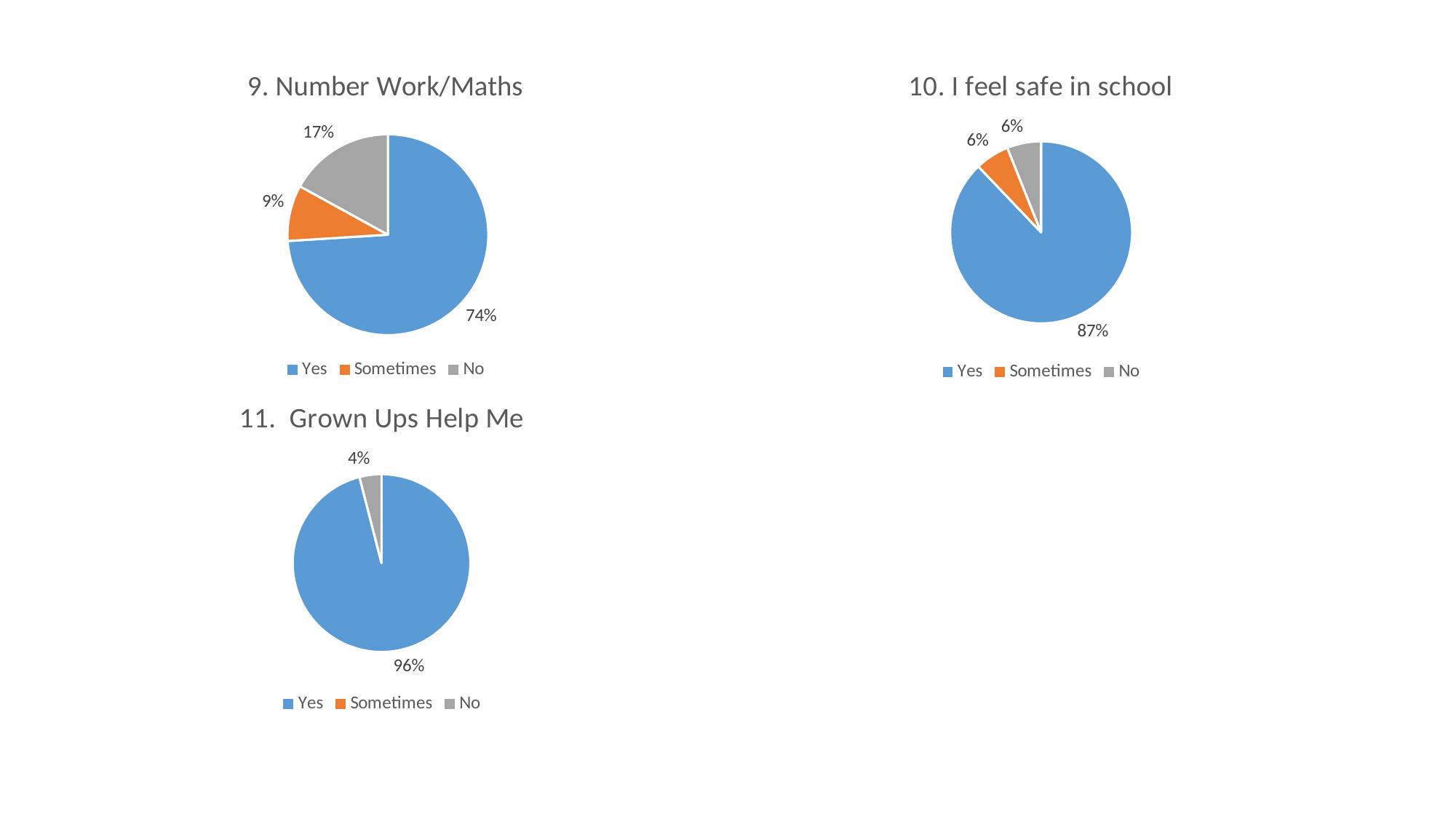
In the "10. I feel safe in school" chart, what percentage is shown for Sometimes? 6% Which chart has the larger Yes share, "9. Number Work/Maths" or "11. Grown Ups Help Me"? 11. Grown Ups Help Me In the "9. Number Work/Maths" chart, what percentage is shown for Sometimes? 9% In the "9. Number Work/Maths" chart, which category has the smallest slice? Sometimes In the "11. Grown Ups Help Me" chart, what percentage is shown for Yes? 96% In the "9. Number Work/Maths" chart, what percentage is shown for No? 17% In the "11. Grown Ups Help Me" chart, what percentage is shown for No? 4% In the "9. Number Work/Maths" chart, what is the difference in percentage points between Yes and No? 57 In the "10. I feel safe in school" chart, what percentage is shown for Yes? 87% What type of chart is "10. I feel safe in school"? Pie chart In the "10. I feel safe in school" chart, which category has the largest slice? Yes In the "9. Number Work/Maths" chart, what percentage is shown for Yes? 74%